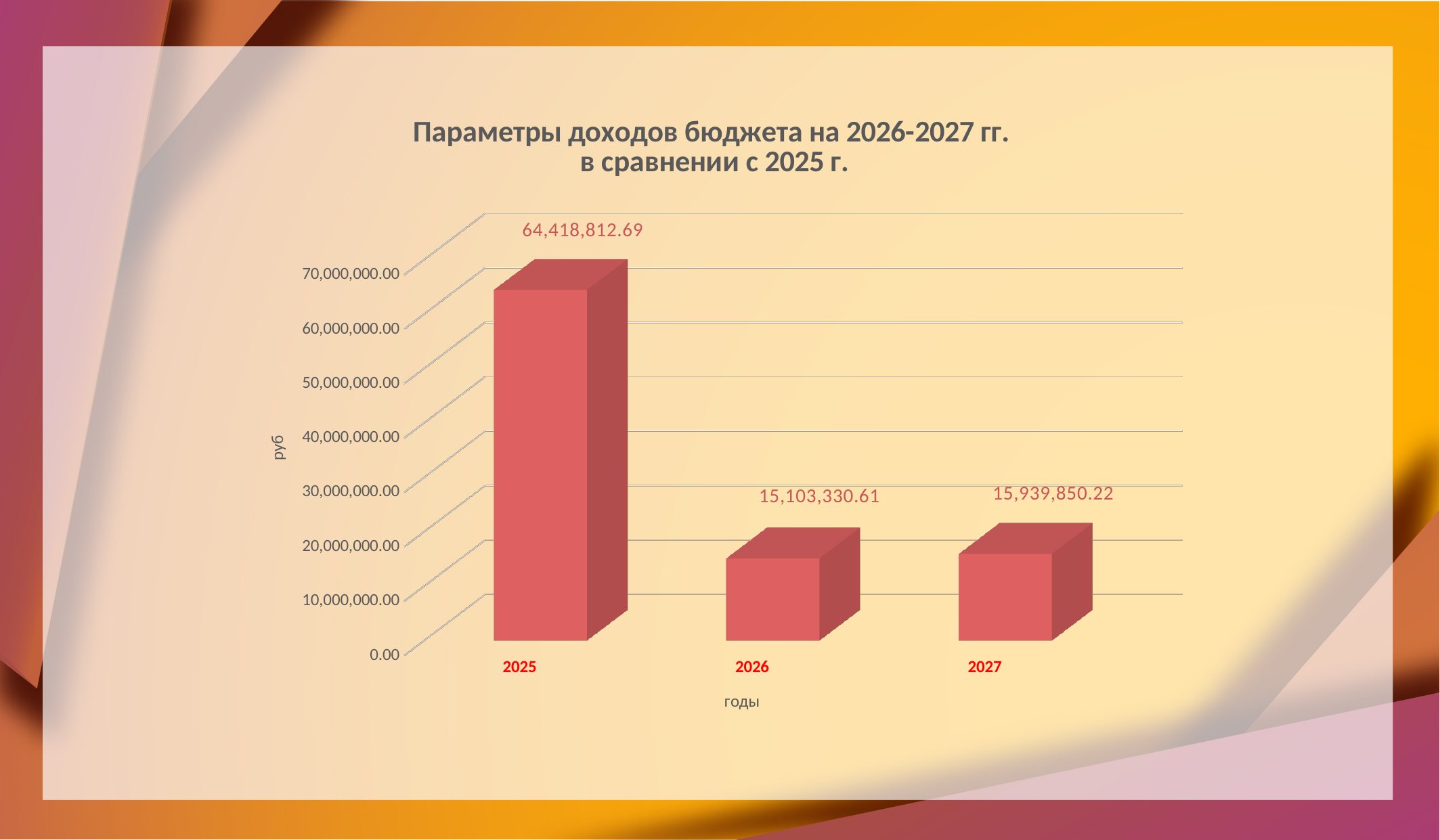
What kind of chart is shown on the slide? Bar chart What is the value for 2027? 15,939,850.22 What is the difference between the values for 2027 and 2026? 836,519.61 Which year has the lowest value? 2026 How many years are shown on the x axis? 3 What is the difference between the values for 2025 and 2026? 49,315,482.08 Is the value for 2025 greater or less than 60,000,000.00? greater Which year has the highest value? 2025 What is the value for 2026? 15,103,330.61 What is the value for 2025? 64,418,812.69 Which is larger, the value for 2026 or the value for 2027? 2027 What is the label of the vertical axis? руб